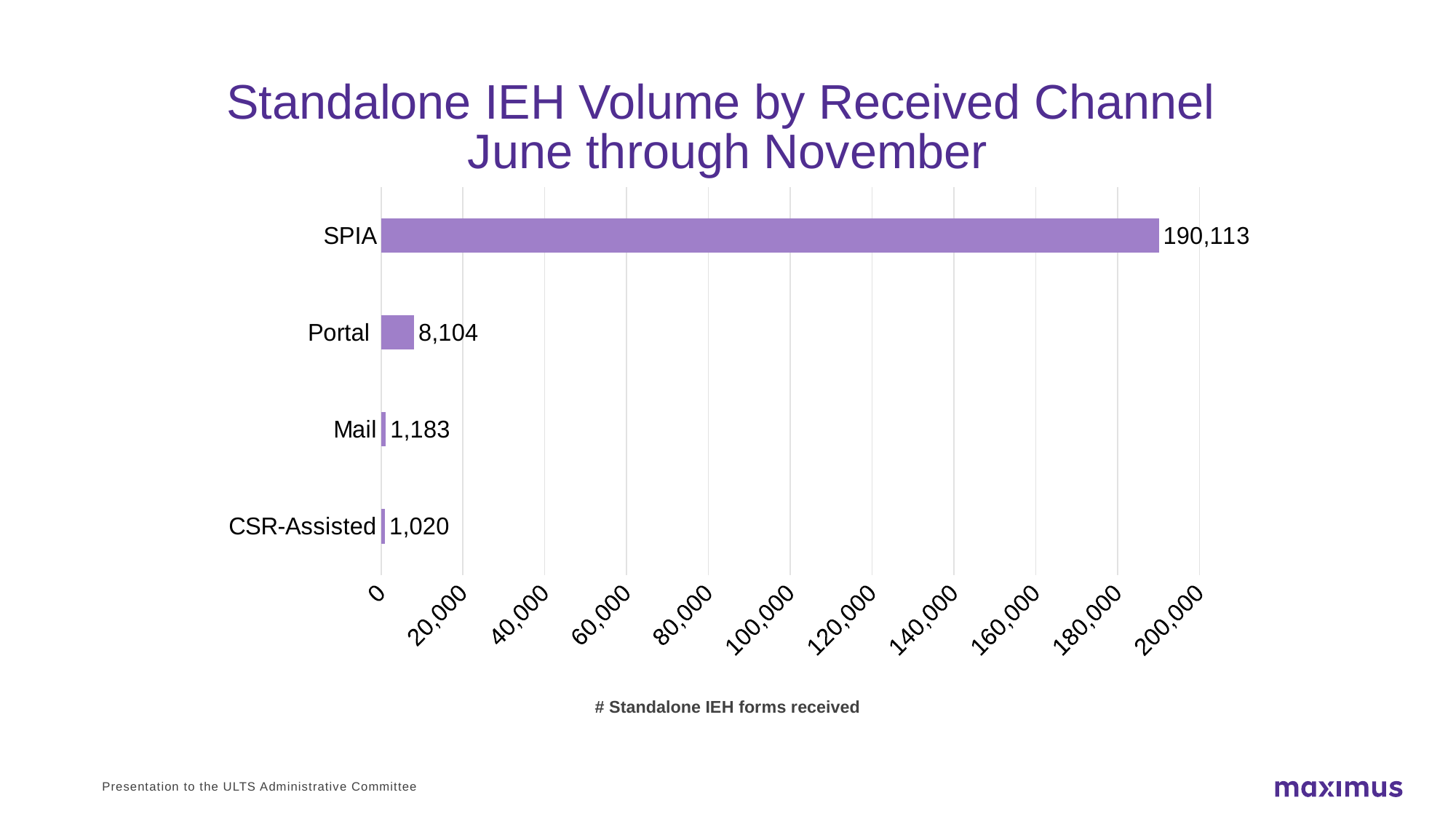
What is the value for CSR-Assisted? 1,020 Which channel has the highest volume? SPIA What is the value for Portal? 8,104 What is the value for SPIA? 190,113 What is the difference between the SPIA and Portal values? 182,009 What is the value for Mail? 1,183 Which is larger, the value for Portal or the value for Mail? Portal How many channels are shown in the chart? 4 What is the difference between the Mail and CSR-Assisted values? 163 What kind of chart is this? Bar chart Which channel has the lowest volume? CSR-Assisted Is the value for SPIA greater or less than 180,000? greater